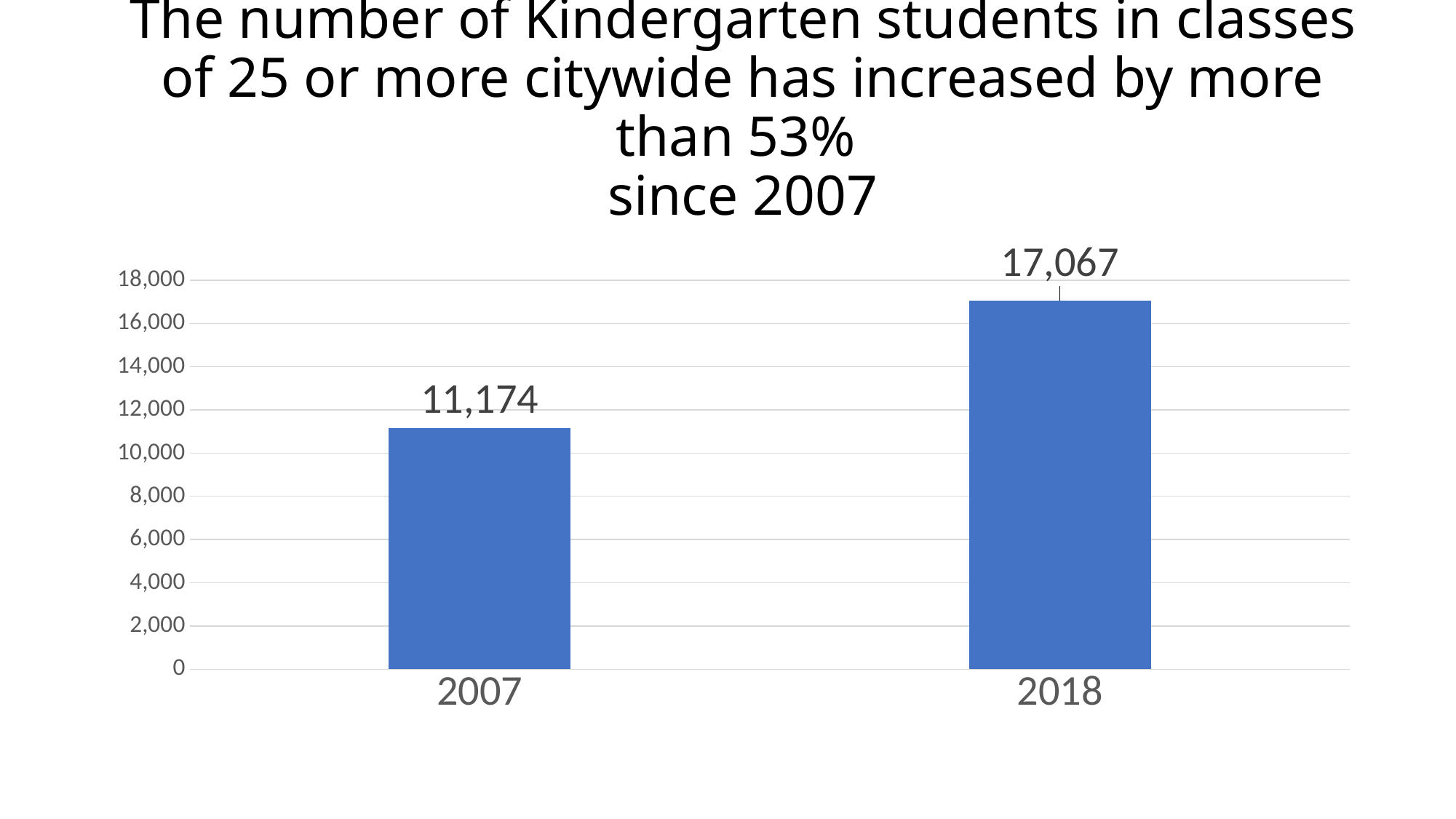
What is the value shown for 2018? 17,067 Is the value for 2007 greater or less than 12,000? less What is the difference between the 2018 value and the 2007 value? 5,893 What kind of chart is shown on the slide? Bar chart What is the highest value labelled on the vertical axis? 18,000 What is the value shown for 2007? 11,174 Which year has the higher value? 2018 Which year has the lower value? 2007 Is the value for 2018 larger than the value for 2007? Yes Do the values rise or fall from 2007 to 2018? Rise How many bars are shown in the chart? 2 Is the value for 2018 greater or less than 16,000? greater